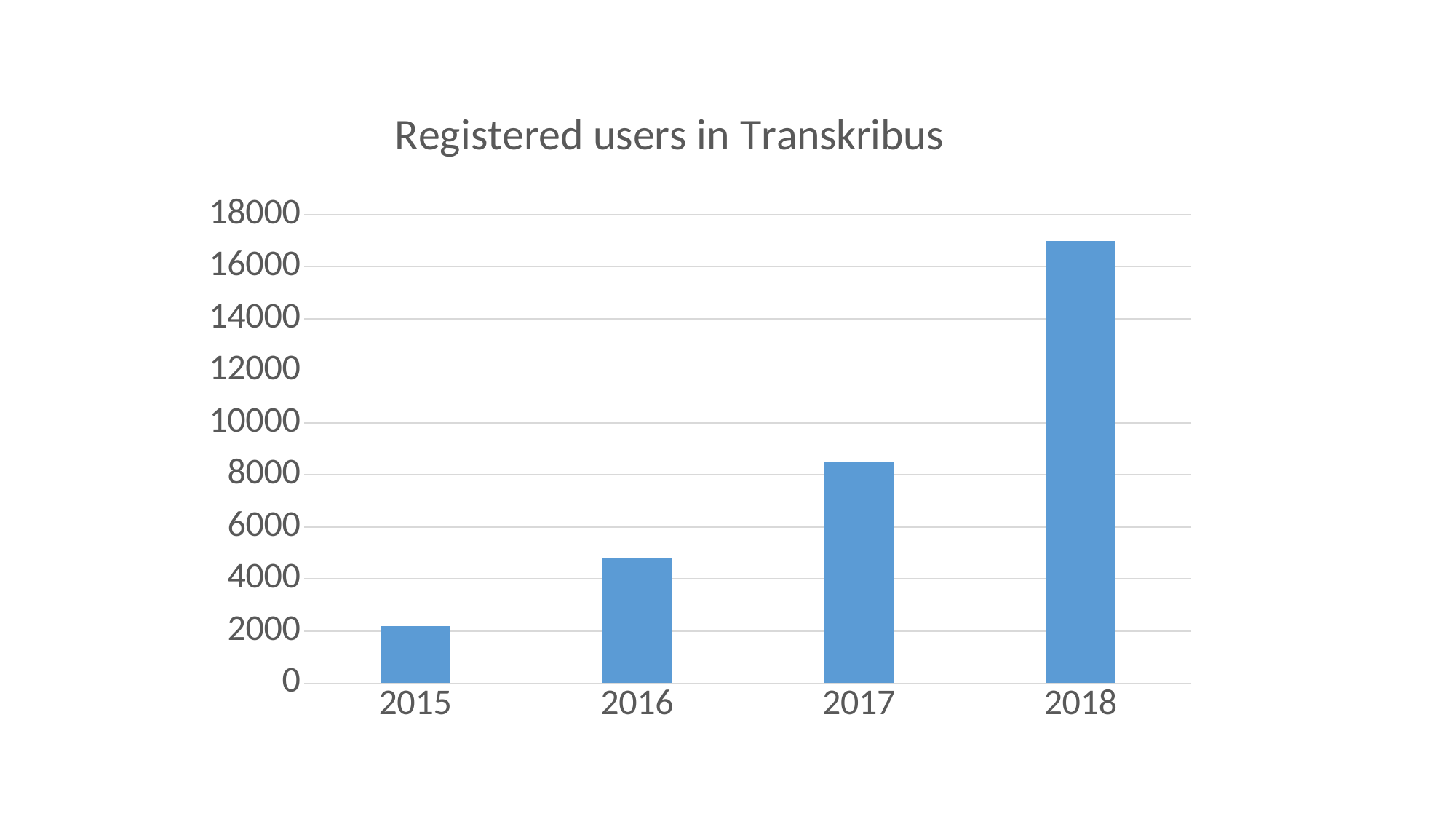
Which year has more registered users, 2016 or 2017? 2017 What is the title of the chart? Registered users in Transkribus Is the value for 2018 greater or less than 16000? greater Which year has the highest number of registered users? 2018 Is the value for 2017 greater or less than 8000? greater What is the highest value labelled on the y axis? 18000 Which year has the lowest number of registered users? 2015 Is the value for 2016 greater or less than 6000? less Do the values rise or fall from 2015 to 2018? rise How many years are shown on the x axis? 4 What kind of chart is shown on the slide? bar chart